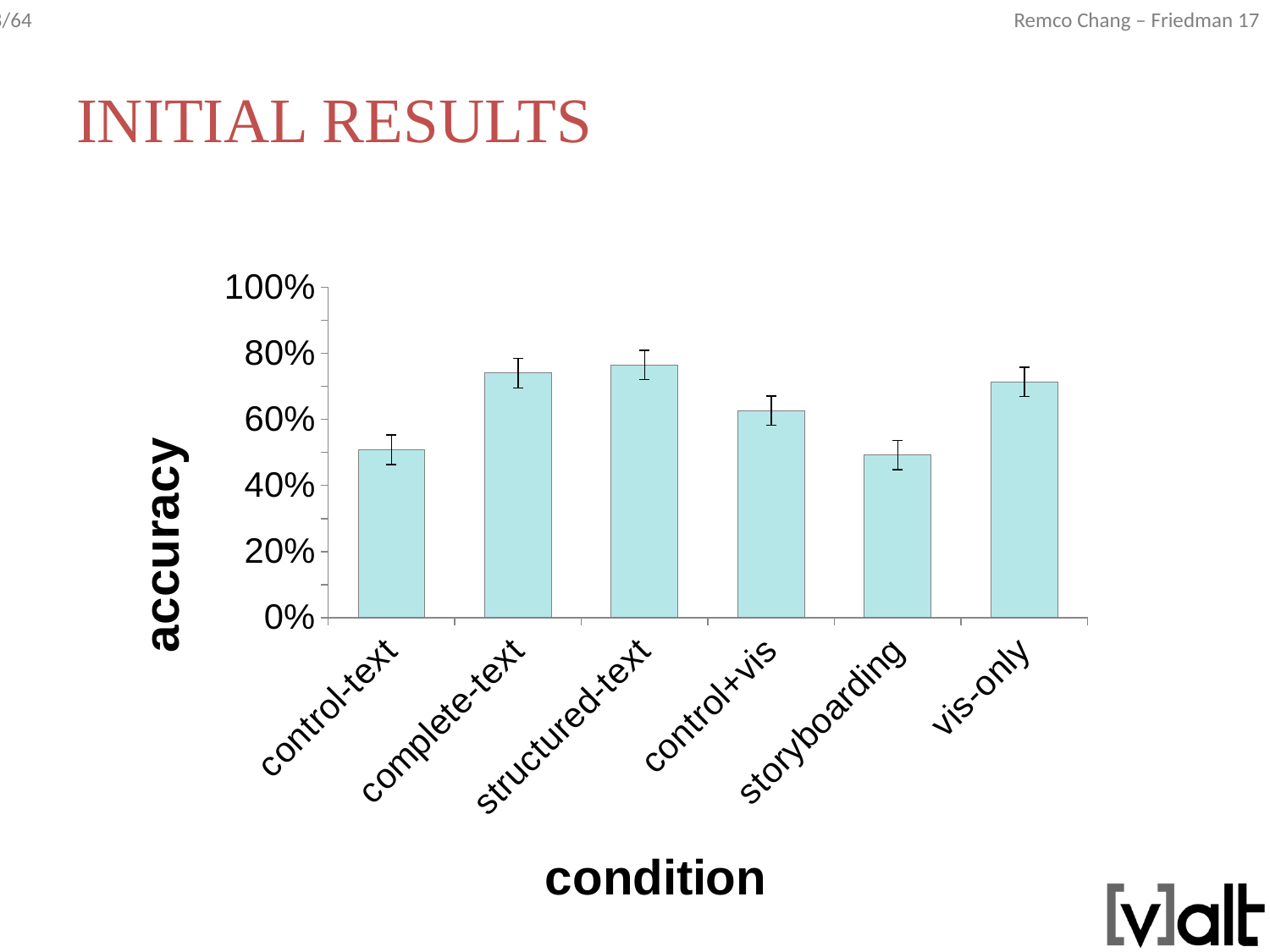
Is the accuracy for vis-only greater or less than 60%? greater Which condition has the higher accuracy, structured-text or storyboarding? structured-text Is the accuracy for complete-text greater or less than 60%? greater Which condition has the higher accuracy, control+vis or control-text? control+vis Is the accuracy for control-text greater or less than 40%? greater What is the label of the x axis of the chart? condition What kind of chart is shown on the slide? bar chart Which condition has the higher accuracy, complete-text or control-text? complete-text How many conditions are plotted on the x axis of the chart? 6 What is the label of the y axis of the chart? accuracy